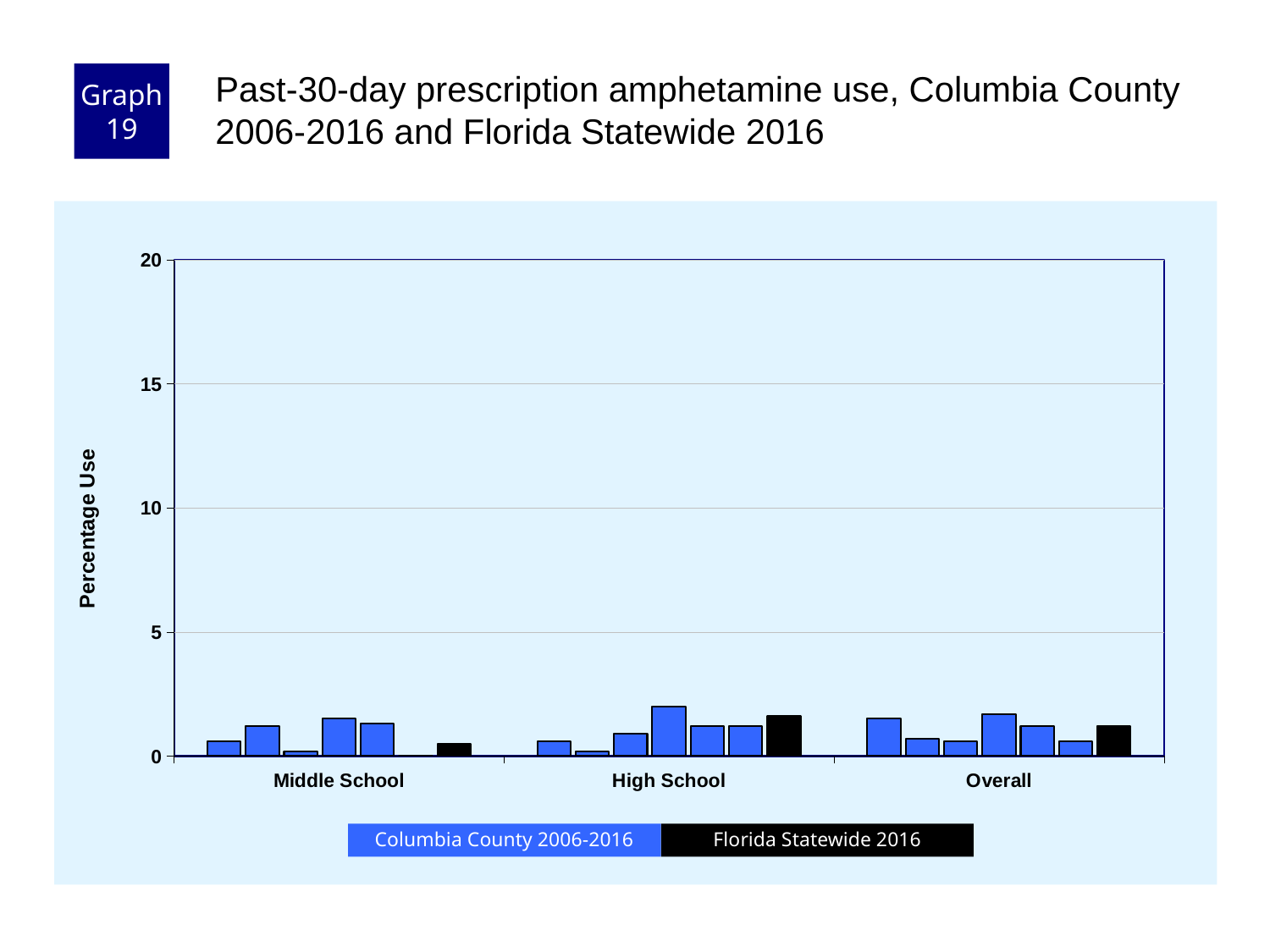
Is the Florida Statewide 2016 value larger for Overall or for Middle School? Overall How many categories are shown on the x axis? 3 Is the Florida Statewide 2016 value for Overall greater or less than 5? less How many series does the legend list? 2 Is the Florida Statewide 2016 value for High School greater or less than 5? less Is the Florida Statewide 2016 value for Middle School greater or less than 5? less Which category has the lowest Florida Statewide 2016 value? Middle School Which series is shown in black in the legend? Florida Statewide 2016 Is the Florida Statewide 2016 value larger for High School or for Middle School? High School Which category has the highest Florida Statewide 2016 value? High School What is the label of the y axis? Percentage Use What kind of chart is shown on the slide? bar chart